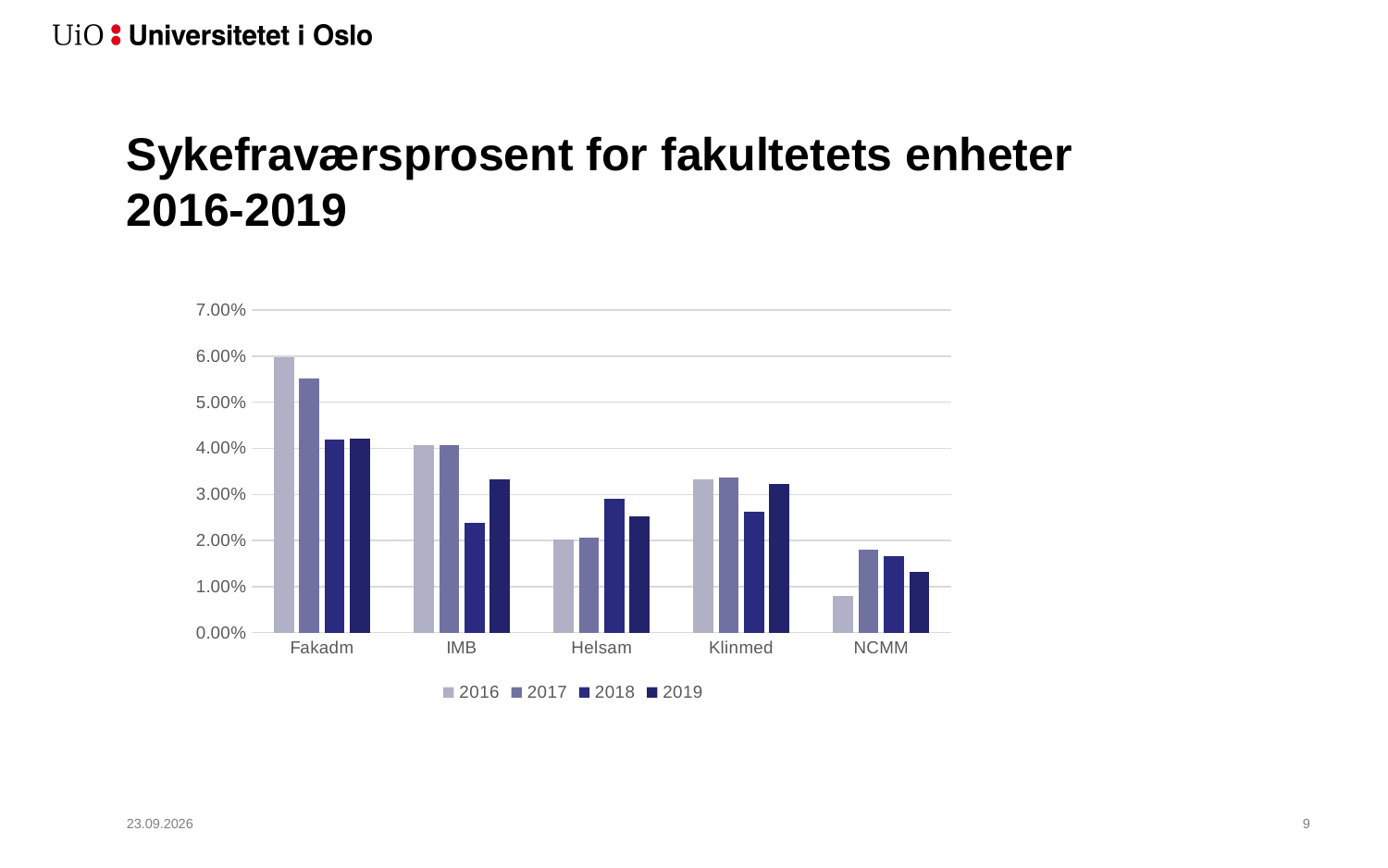
Which unit has the lowest sick leave percentage for 2016? NCMM How many units (categories) are shown on the x axis of the chart? 5 Is the 2019 value for Helsam greater or less than 2.00%? greater Is the 2018 value for IMB greater or less than 3.00%? less What kind of chart is shown on the slide? Bar chart For Helsam, which year has the larger value: 2016 or 2018? 2018 Does the sick leave percentage for Fakadm rise or fall from 2016 to 2018? fall For Klinmed, which year has the larger value: 2018 or 2019? 2019 Is the 2016 value for NCMM greater or less than 1.00%? less Which unit has the highest sick leave percentage for 2016? Fakadm How many series does the legend list? 4